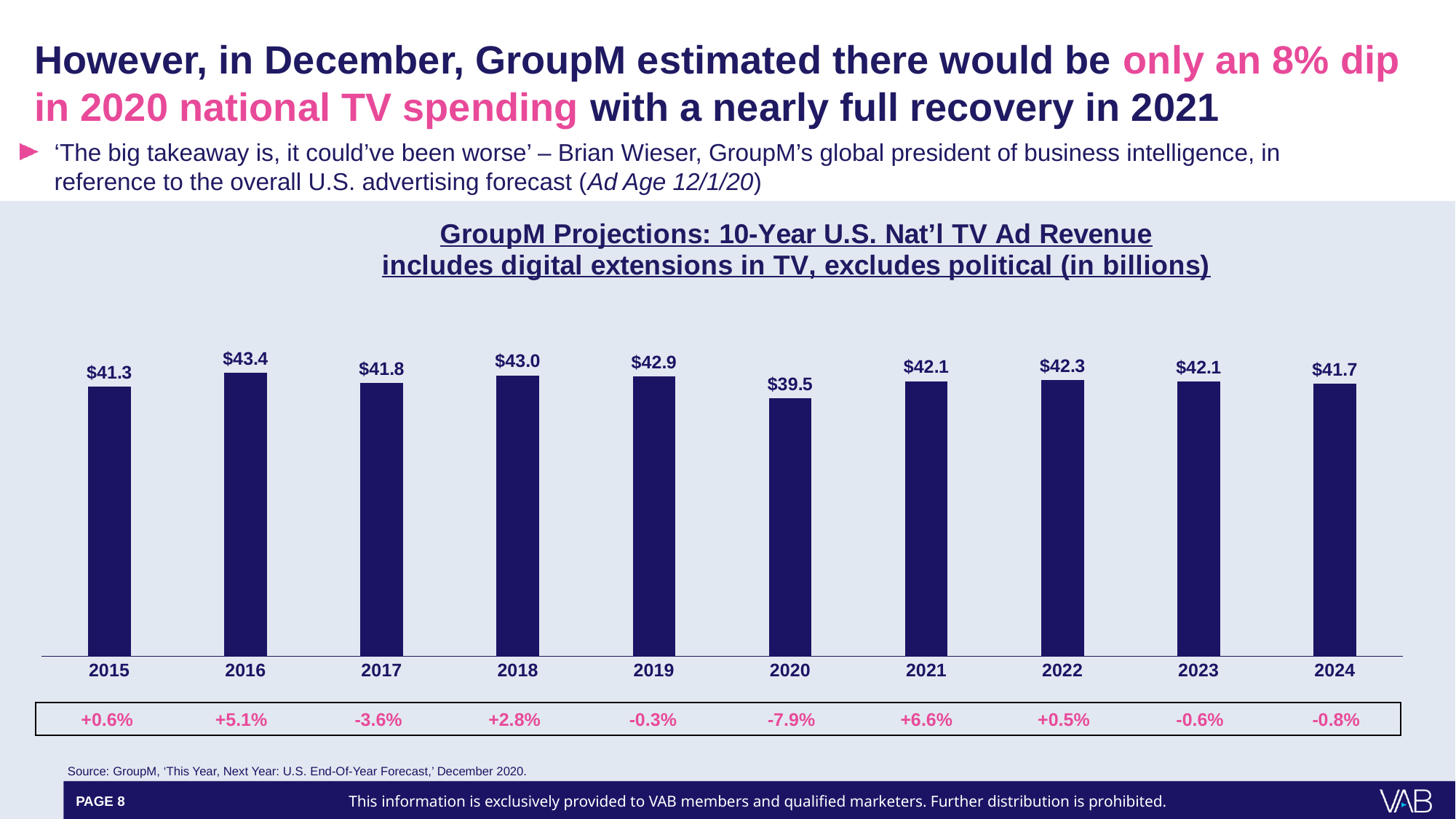
Does the revenue rise or fall from 2019 to 2020? Fall What year-over-year percentage change is shown beneath 2021? +6.6% What is the difference between the 2019 value and the 2020 value? $3.4 What is the title of the chart? GroupM Projections: 10-Year U.S. Nat'l TV Ad Revenue includes digital extensions in TV, excludes political (in billions) What is the value shown for 2016? $43.4 How many years are shown on the x axis? 10 What is the projected U.S. national TV ad revenue for 2020? $39.5 Is the value for 2018 larger than the value for 2017? Yes What year-over-year percentage change is shown beneath 2020? -7.9% What kind of chart is shown on the slide? Bar chart Which year has the highest national TV ad revenue? 2016 Which year has the lowest national TV ad revenue? 2020